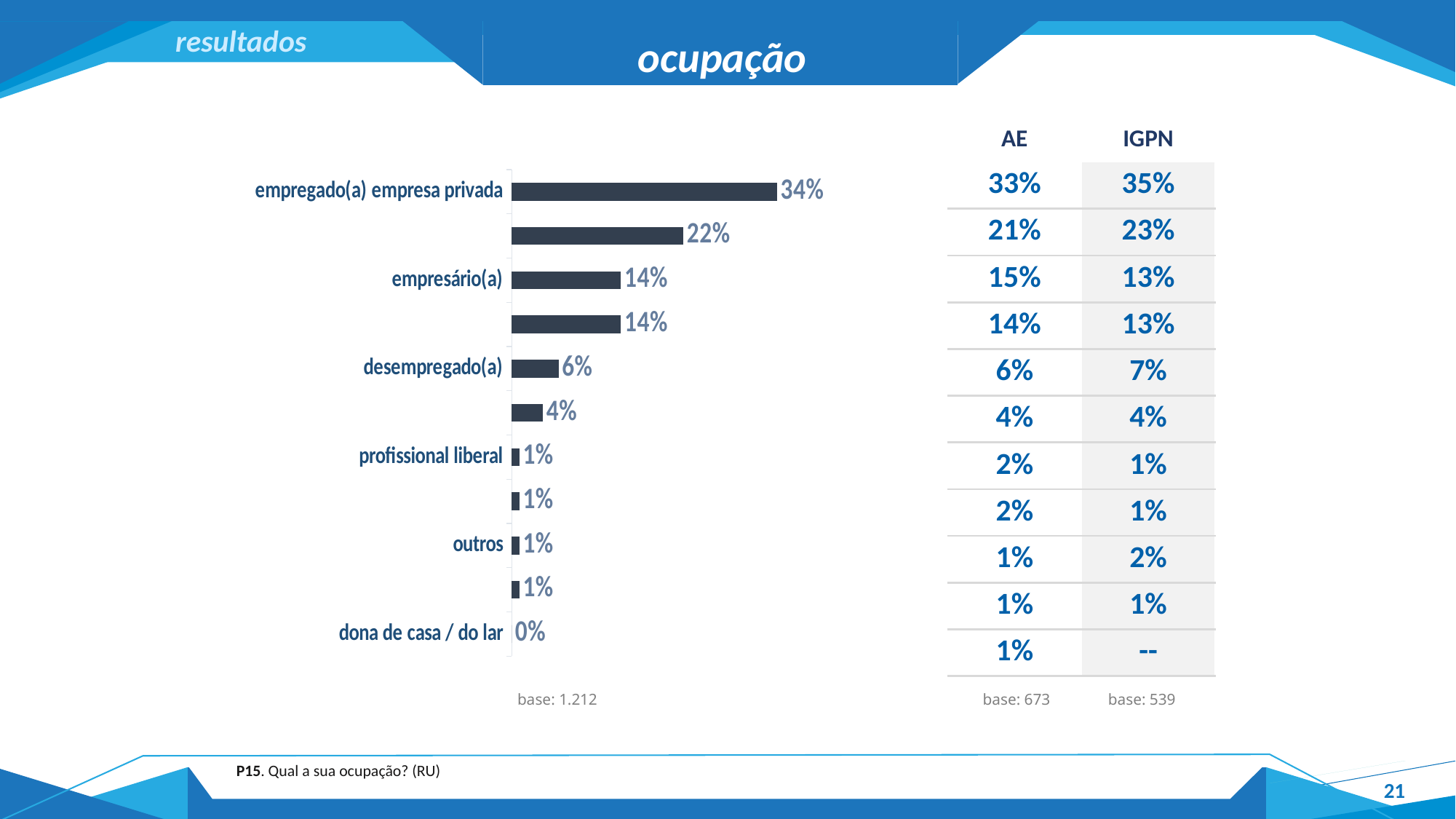
What is the value for empresário(a)? 14% What kind of chart is shown on the slide? bar chart What base (number of respondents) is shown below the bar chart? base: 1.212 Which category has the lowest value in the chart? dona de casa / do lar What is the value for empregado(a) empresa privada? 34% What is the title of the chart shown on the slide? ocupação What is the difference between the values for empregado(a) empresa privada and empresário(a)? 20 percentage points What is the value for profissional liberal? 1% Which is larger, the value for empresário(a) or the value for desempregado(a)? empresário(a) What is the value for dona de casa / do lar? 0% What is the value for desempregado(a)? 6% Which category has the highest value in the chart? empregado(a) empresa privada